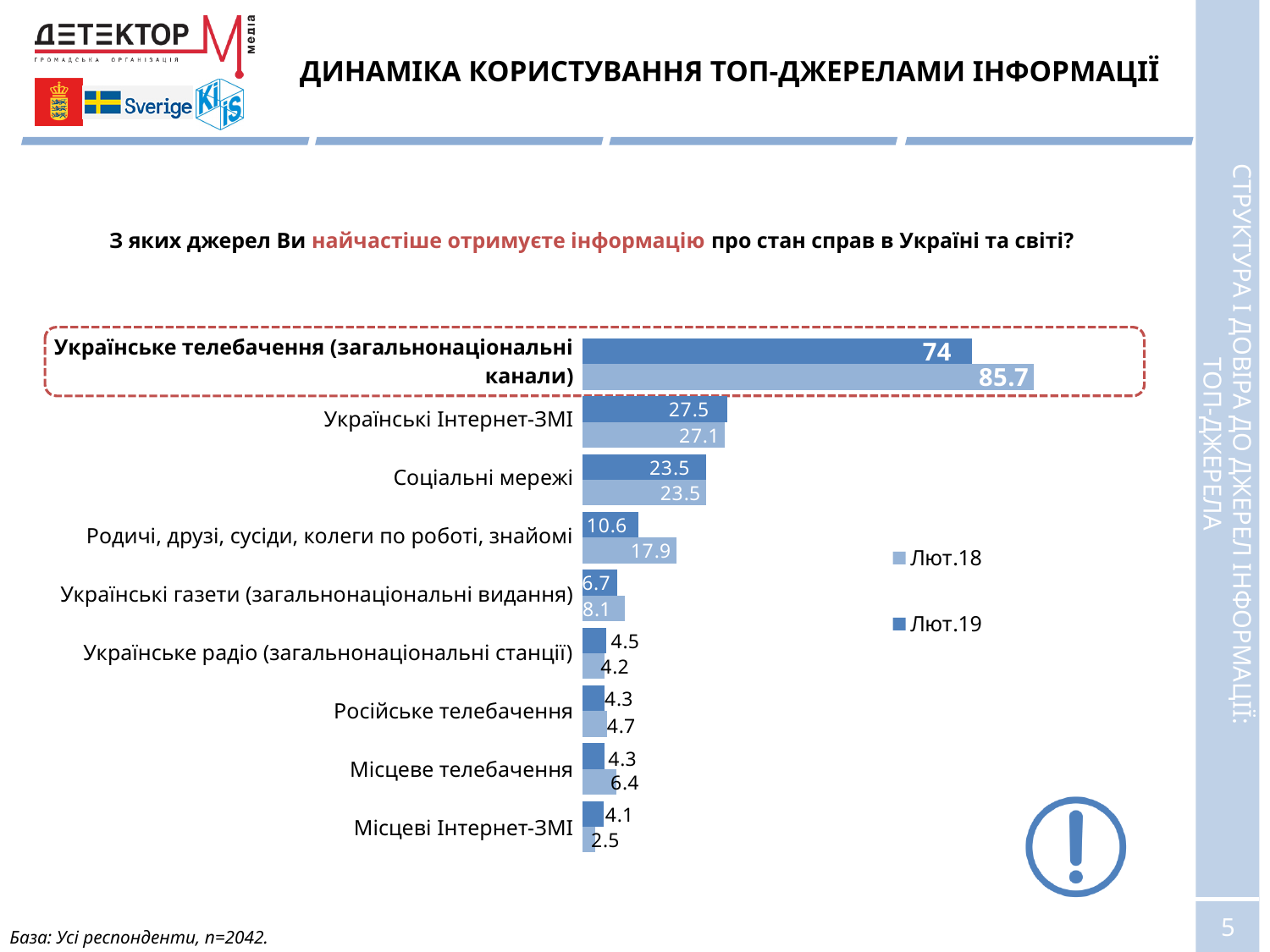
For Місцеве телебачення, which is larger: the Лют.18 value or the Лют.19 value? Лют.18 Which series is shown in the darker blue colour? Лют.19 What is the Лют.19 value for Українські Інтернет-ЗМІ? 27.5 How many information sources (categories) are shown in the chart? 9 What is the Лют.18 value for Родичі, друзі, сусіди, колеги по роботі, знайомі? 17.9 Which source has the lowest Лют.18 value? Місцеві Інтернет-ЗМІ What is the difference between the Лют.18 and Лют.19 values for Українське телебачення (загальнонаціональні канали)? 11.7 Which source has the highest Лют.19 value? Українське телебачення (загальнонаціональні канали) What is the Лют.19 value for Українське телебачення (загальнонаціональні канали)? 74 What is the Лют.18 value for Українське телебачення (загальнонаціональні канали)? 85.7 How many series does the legend list? 2 What kind of chart is shown on the slide? bar chart